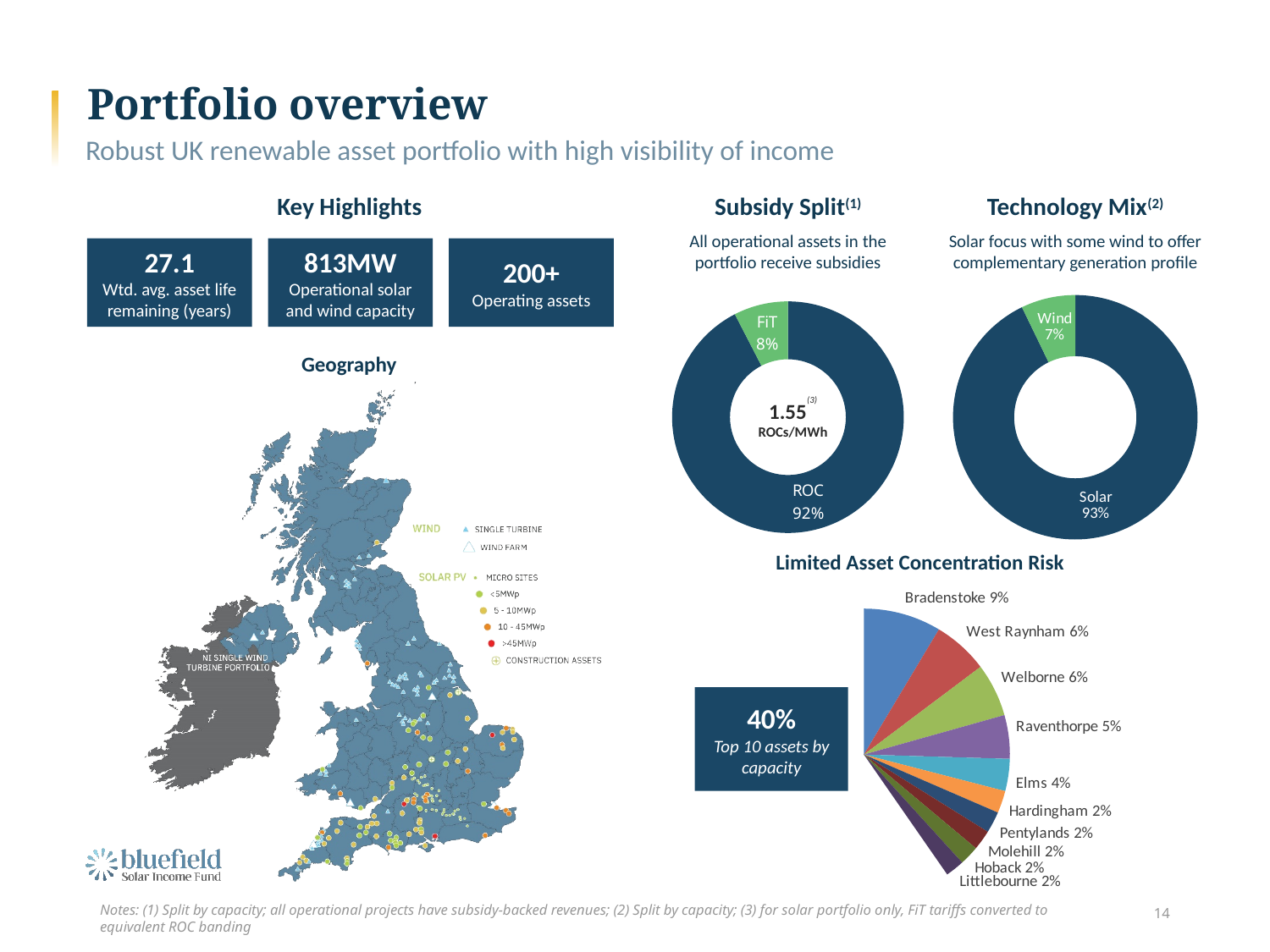
In the Limited Asset Concentration Risk chart, how many assets are labelled? 10 In the Limited Asset Concentration Risk chart, what is the share for Raventhorpe? 5% In the Limited Asset Concentration Risk chart, what is the share for Elms? 4% In the Limited Asset Concentration Risk chart, what is the difference between Bradenstoke's share and West Raynham's share? 3% In the Technology Mix chart, which segment is larger, Solar or Wind? Solar In the Technology Mix chart, what share is Wind? 7% In the Technology Mix chart, what share is Solar? 93% In the Subsidy Split chart, what share is FiT? 8% In the Subsidy Split chart, what share of the portfolio receives ROC subsidies? 92% In the Limited Asset Concentration Risk chart, which asset has the largest share? Bradenstoke What kind of chart is the Technology Mix chart? Donut chart In the Subsidy Split chart, what is the difference between the ROC share and the FiT share? 84%